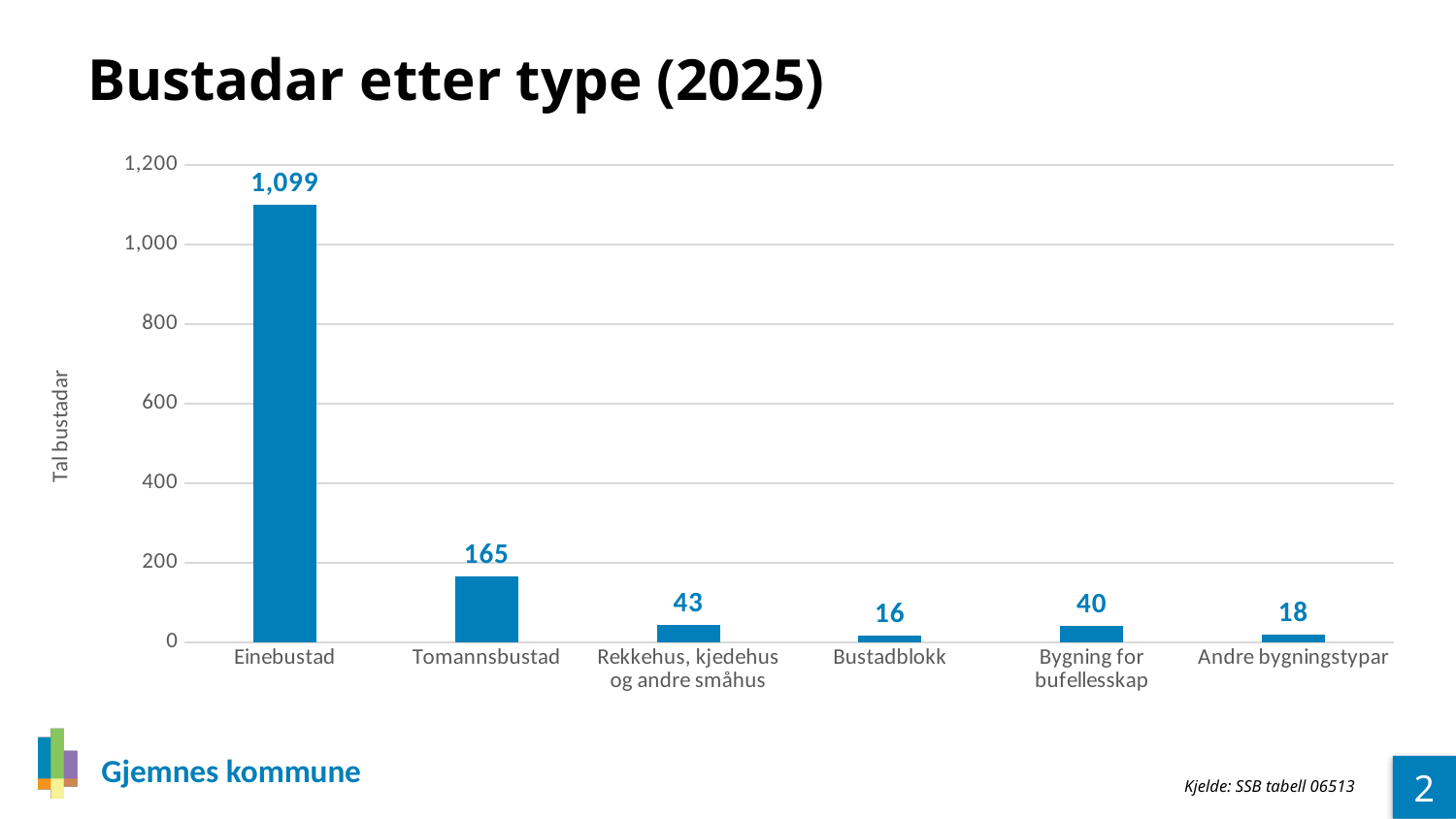
What is the value for Tomannsbustad? 165 How many categories are shown on the x axis? 6 What is the value for Bygning for bufellesskap? 40 What is the value for Bustadblokk? 16 What is the difference between the values for Einebustad and Tomannsbustad? 934 Which is larger, the value for Andre bygningstypar or the value for Bustadblokk? Andre bygningstypar What is the value for Einebustad? 1,099 What is the difference between the values for Rekkehus, kjedehus og andre småhus and Bygning for bufellesskap? 3 Which category has the highest value? Einebustad Which category has the lowest value? Bustadblokk What kind of chart is shown on the slide? bar chart What is the title of the chart? Bustadar etter type (2025)